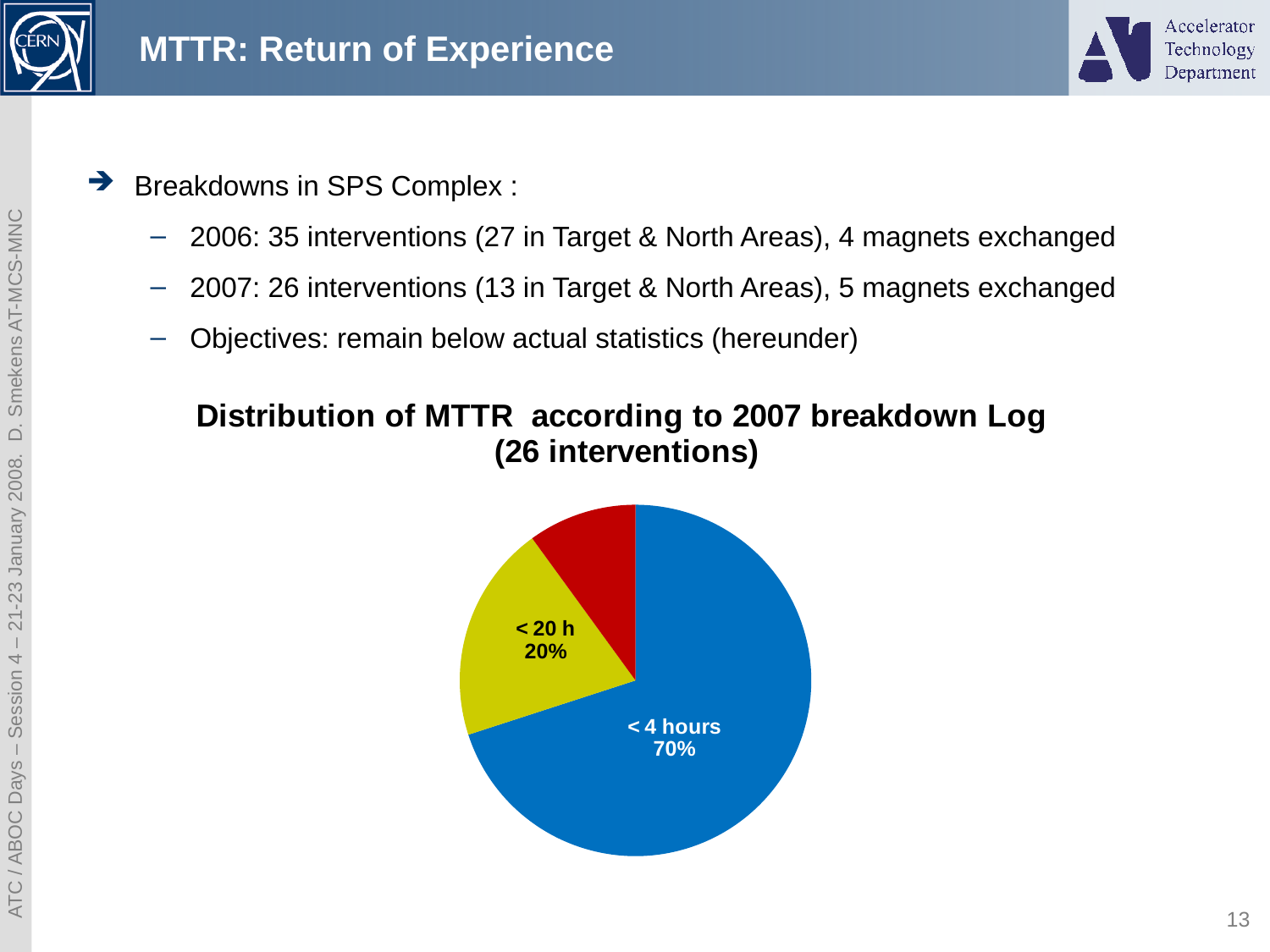
What kind of chart is shown on the slide? pie chart How many interventions does the chart title say the distribution is based on? 26 How many slices does the pie chart have? 3 Which is larger, the "< 4 hours" slice or the "< 20 h" slice? < 4 hours What share of the pie is labelled "< 20 h"? 20% What is the title of the chart? Distribution of MTTR according to 2007 breakdown Log (26 interventions) What share of the pie is labelled "< 4 hours"? 70% By how many percentage points does the "< 4 hours" slice exceed the "< 20 h" slice? 50 percentage points What colour is the "< 4 hours" slice? blue Which labelled slice of the pie is the largest? < 4 hours